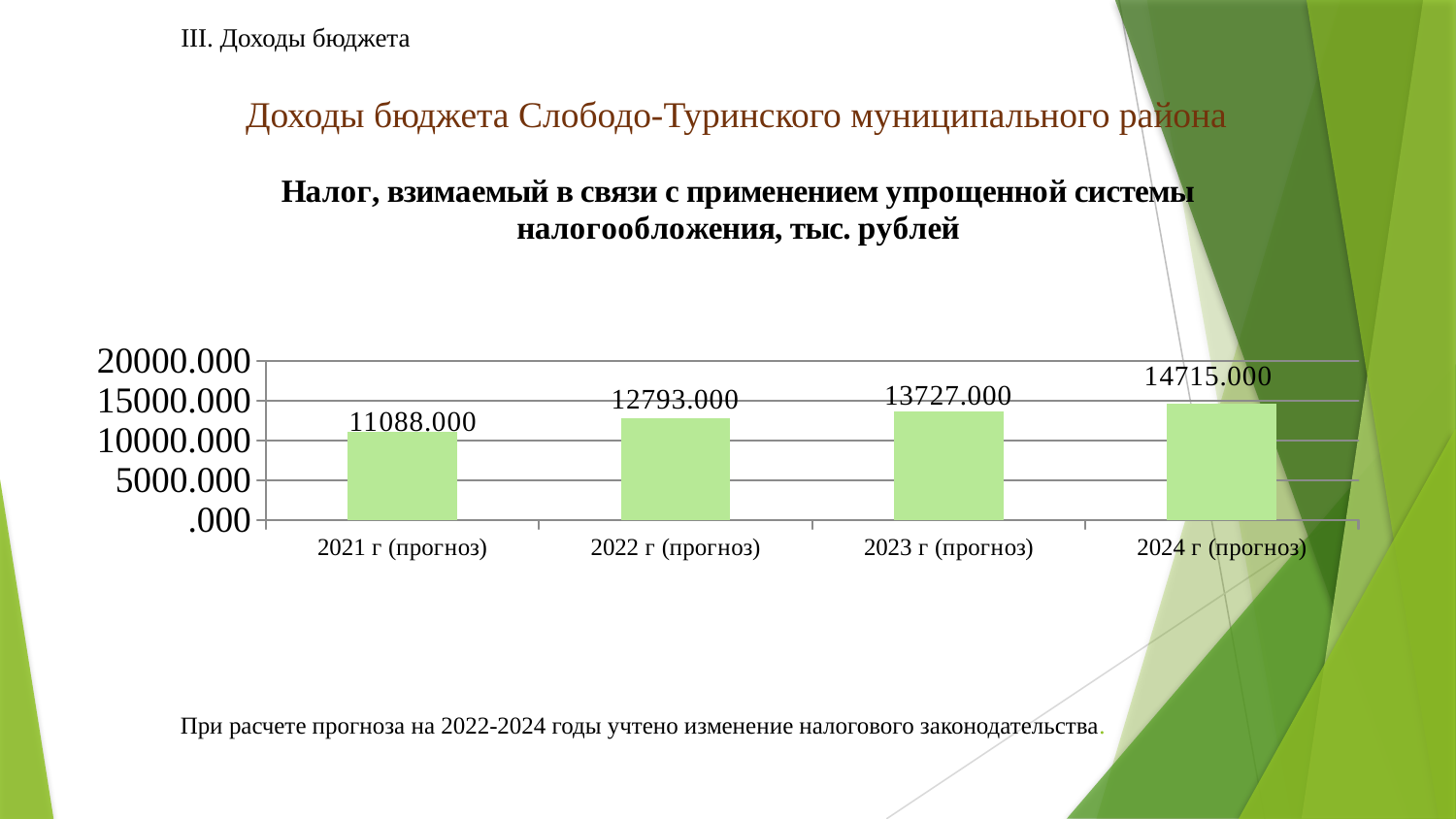
How many bars are shown in the chart? 4 What is the value for 2021 г (прогноз)? 11088.000 Which is larger, the value for 2022 г (прогноз) or 2023 г (прогноз)? 2023 г (прогноз) What kind of chart is shown on the slide? bar chart Which year has the lowest value? 2021 г (прогноз) Which year has the highest value? 2024 г (прогноз) What is the value for 2022 г (прогноз)? 12793.000 What is the value for 2023 г (прогноз)? 13727.000 Do the values rise or fall from 2021 to 2024? rise Is the value for 2021 г (прогноз) greater or less than 10000.000? greater What is the value for 2024 г (прогноз)? 14715.000 What is the difference between the values for 2024 г (прогноз) and 2021 г (прогноз)? 3627.000